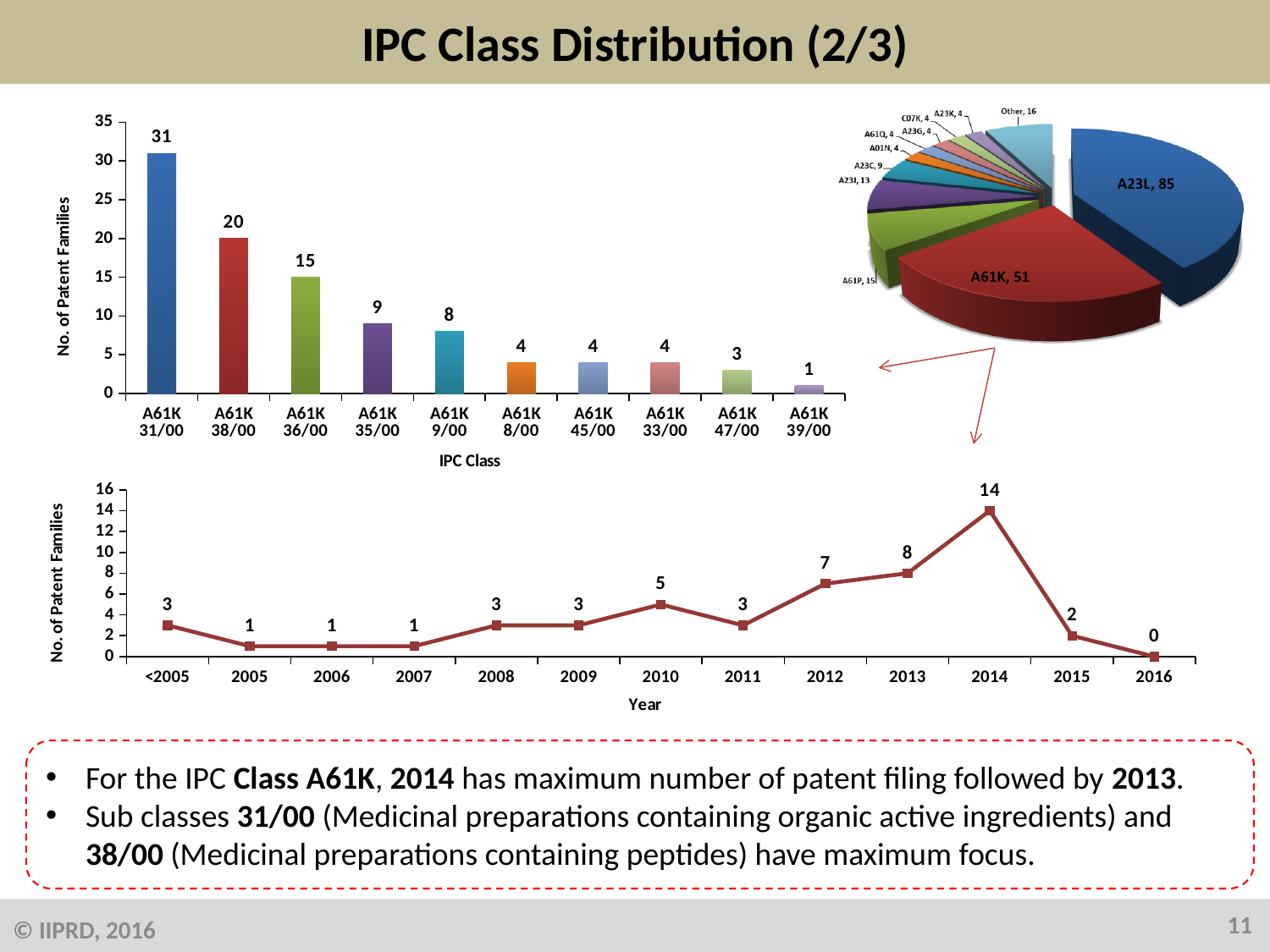
In the bar chart on the left, which has more patent families, A61K 36/00 or A61K 35/00? A61K 36/00 In the line chart at the bottom, what is the difference in patent families between 2014 and 2015? 12 In the bar chart on the left, how many IPC classes are shown on the x axis? 10 In the line chart at the bottom, which year has the highest number of patent families? 2014 In the line chart at the bottom, how many patent families were filed in 2012? 7 In the bar chart on the left, which IPC class has the lowest number of patent families? A61K 39/00 In the line chart at the bottom, do the values rise or fall from 2011 to 2014? rise In the bar chart on the left, what is the difference in patent families between A61K 31/00 and A61K 38/00? 11 In the line chart at the bottom, how many data points are plotted along the x axis? 13 In the bar chart on the left, how many patent families are there for IPC class A61K 31/00? 31 In the pie chart at the top right, what is the value for A23L? 85 What kind of chart is the chart at the top right of the slide? pie chart